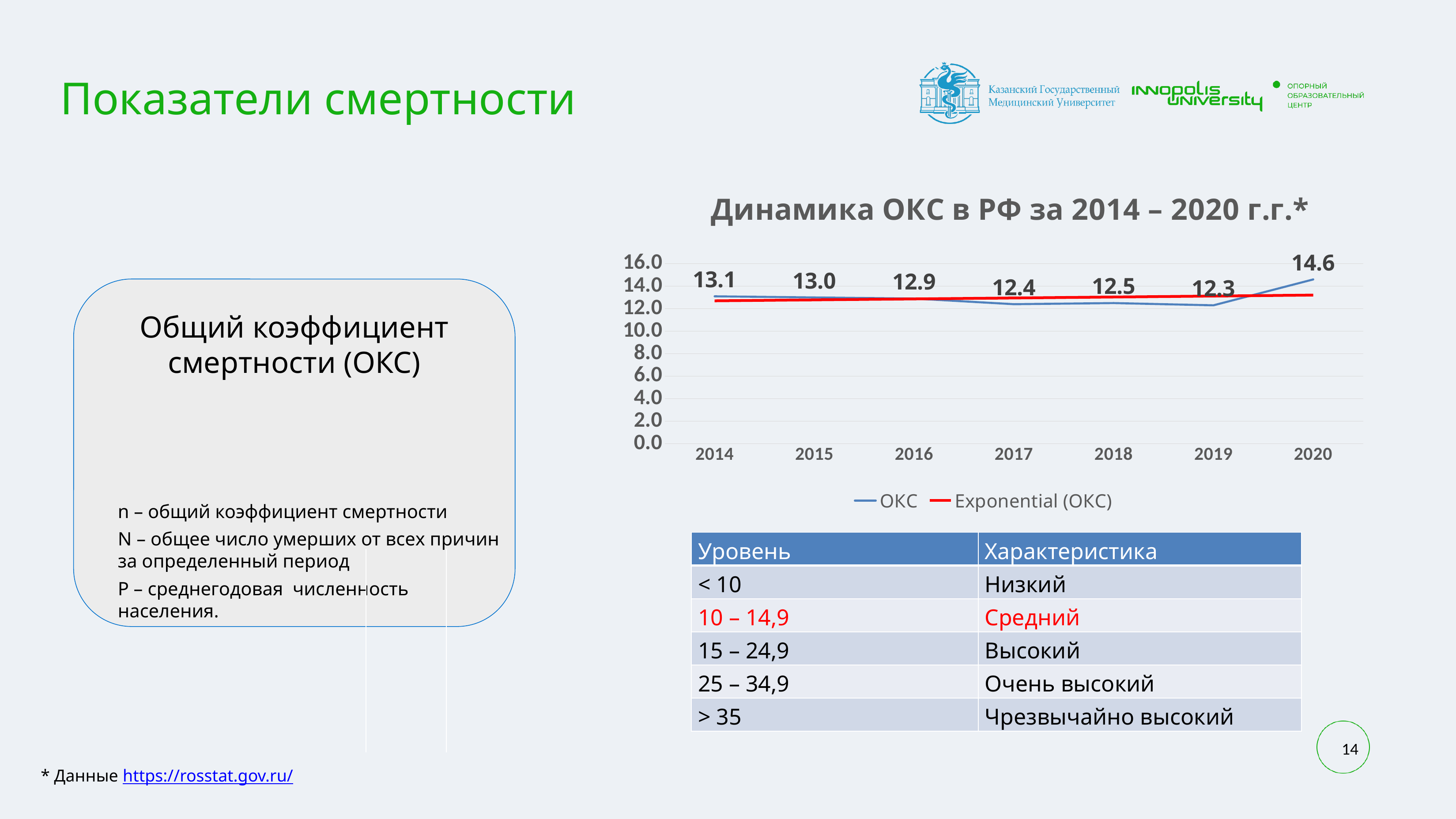
Is the ОКС value for 2016 greater or less than 14.0? less What kind of chart is shown on the slide? line chart How many years are plotted on the x axis of the chart? 7 What is the ОКС value for 2014? 13.1 Which year has the highest ОКС value? 2020 How many series does the chart legend list? 2 What is the title of the chart? Динамика ОКС в РФ за 2014 – 2020 г.г.* What is the ОКС value for 2020? 14.6 What is the difference between the ОКС values for 2020 and 2019? 2.3 What is the ОКС value for 2017? 12.4 Which year has the lowest ОКС value? 2019 Which year has a larger ОКС value, 2014 or 2018? 2014